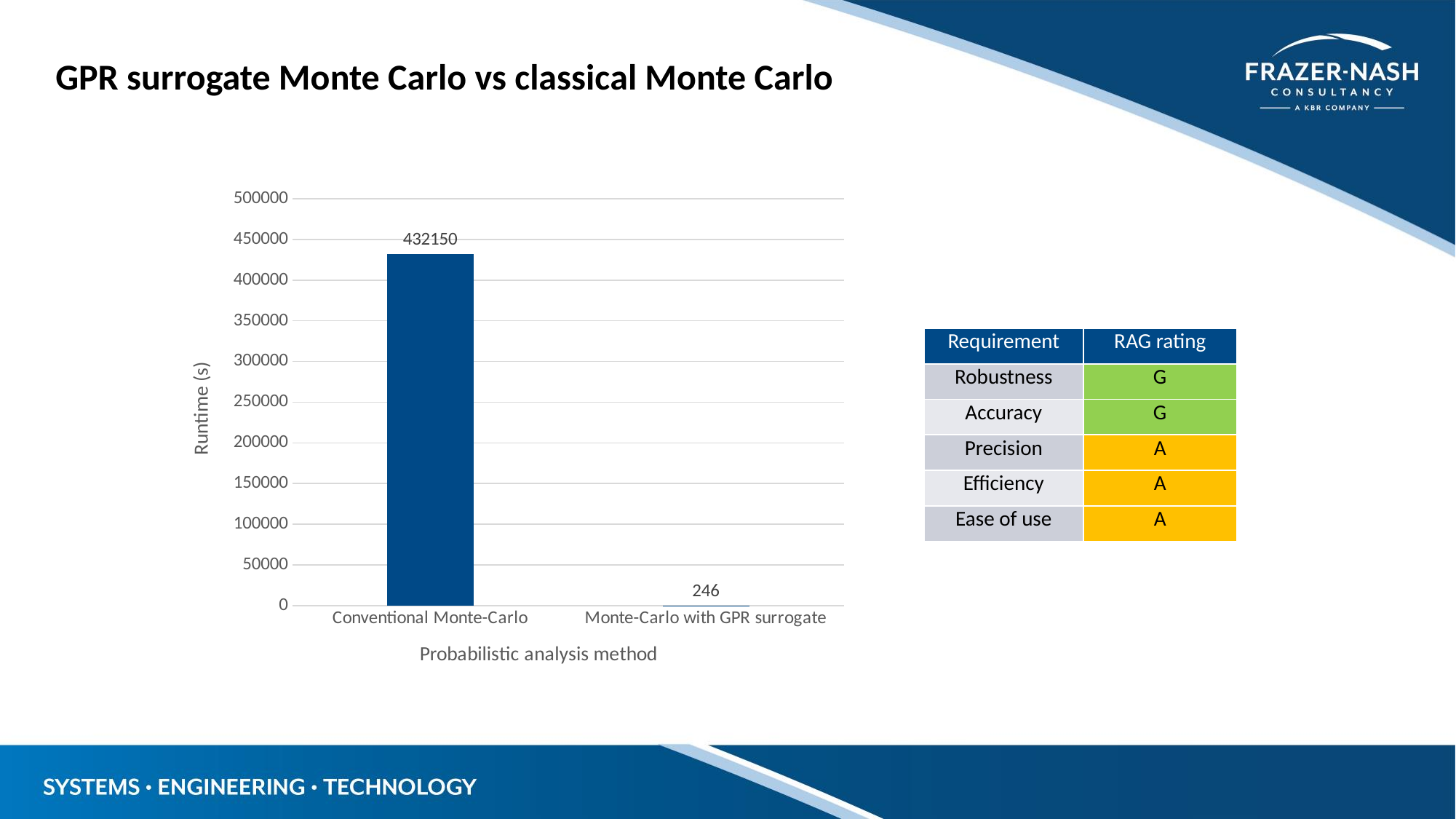
What is the runtime in seconds for Conventional Monte-Carlo? 432150 Is the runtime for Conventional Monte-Carlo greater or less than 400000? greater What is the label of the x axis of the chart? Probabilistic analysis method Which probabilistic analysis method has the lowest runtime? Monte-Carlo with GPR surrogate What is the difference in runtime between Conventional Monte-Carlo and Monte-Carlo with GPR surrogate? 431904 Which probabilistic analysis method has the highest runtime? Conventional Monte-Carlo How many probabilistic analysis methods are shown on the chart? 2 What is the runtime in seconds for Monte-Carlo with GPR surrogate? 246 Which has a larger runtime, Conventional Monte-Carlo or Monte-Carlo with GPR surrogate? Conventional Monte-Carlo What is the label of the y axis of the chart? Runtime (s) Is the runtime for Monte-Carlo with GPR surrogate greater or less than 50000? less What kind of chart is shown on the slide? Bar chart